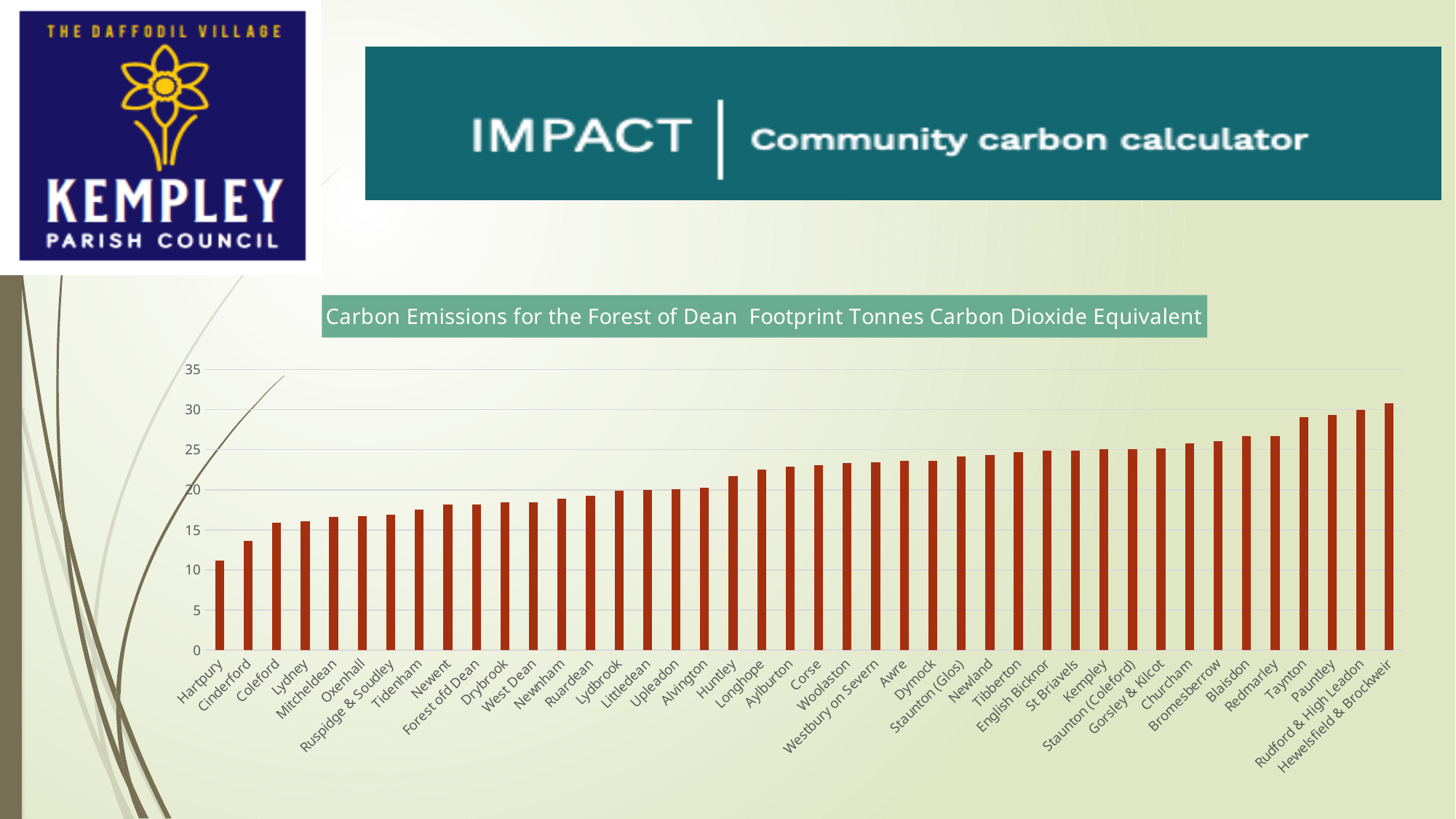
How many categories are plotted in the chart? 42 Which has the larger value, Cinderford or Taynton? Taynton What is the title of the chart? Carbon Emissions for the Forest of Dean Footprint Tonnes Carbon Dioxide Equivalent Which category has the highest value in the chart? Hewelsfield & Brockweir What kind of chart is shown on the slide? Bar chart Do the values rise or fall from left to right along the x axis? Rise Is the value for Hewelsfield & Brockweir greater or less than 30? greater Is the value for Huntley greater or less than 20? greater Which category has the lowest value in the chart? Hartpury Which has the larger value, Kempley or Hartpury? Kempley Is the value for Hartpury greater or less than 15? less